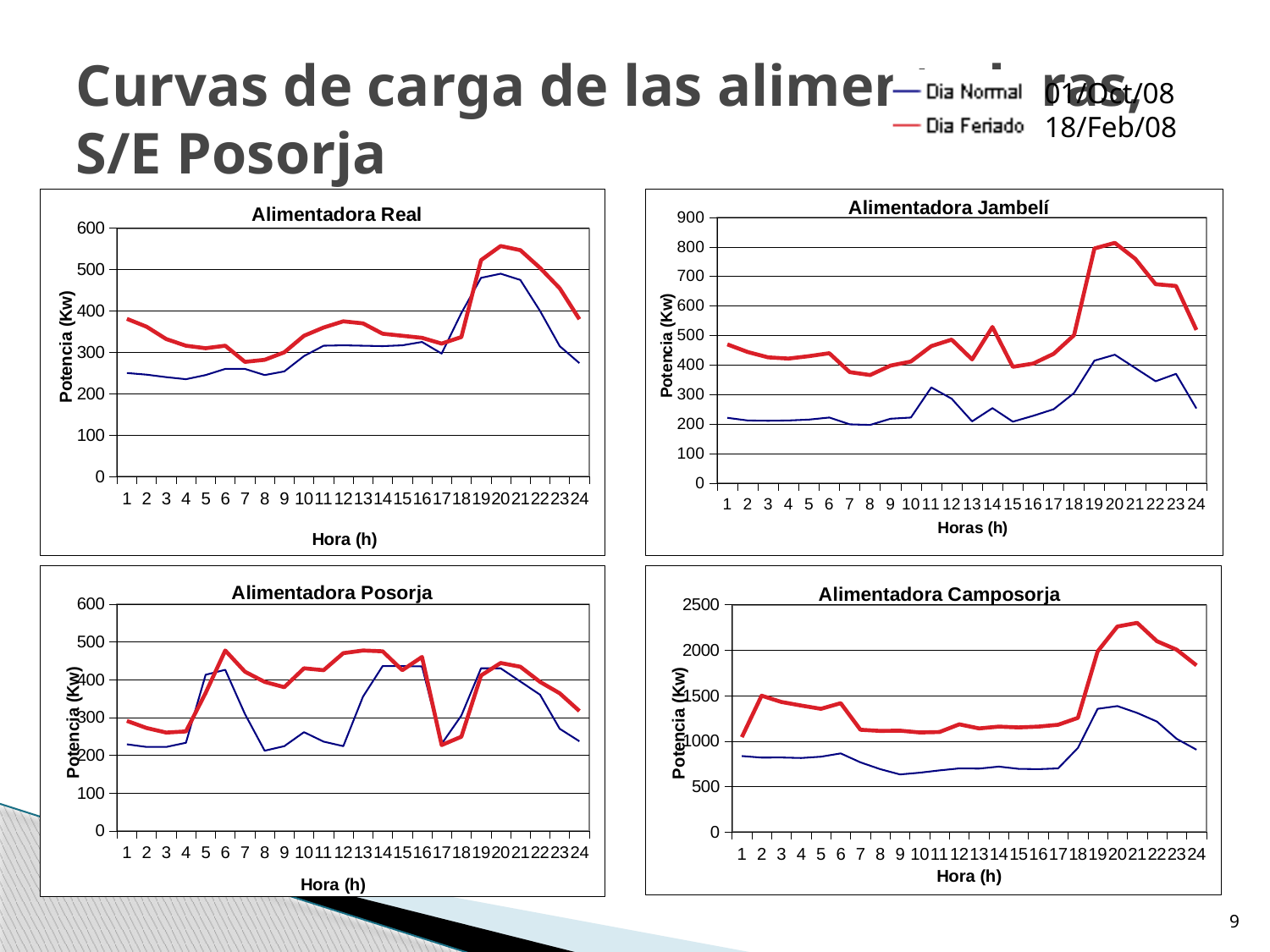
How many series does the legend at the top of the slide list? 2 In the Alimentadora Jambelí chart, at which hour does the Dia Feriado series reach its lowest value? 8 In the Alimentadora Posorja chart, at which hour does the Dia Feriado series reach its lowest value? 17 What kind of chart is the Alimentadora Real chart? line chart In the Alimentadora Real chart, is the Dia Feriado value at hour 20 greater or less than 500? greater In the Alimentadora Jambelí chart, at hour 20, which series has the larger value, Dia Normal or Dia Feriado? Dia Feriado In the Alimentadora Camposorja chart, is the Dia Normal value at hour 9 greater or less than 1000? less In the Alimentadora Real chart, is the Dia Normal value at hour 1 greater or less than 300? less In the Alimentadora Camposorja chart, does the Dia Feriado series rise or fall from hour 21 to hour 24? fall What is the y-axis label of the Alimentadora Jambelí chart? Potencia (Kw) How many hour points are plotted along the x axis of the Alimentadora Posorja chart? 24